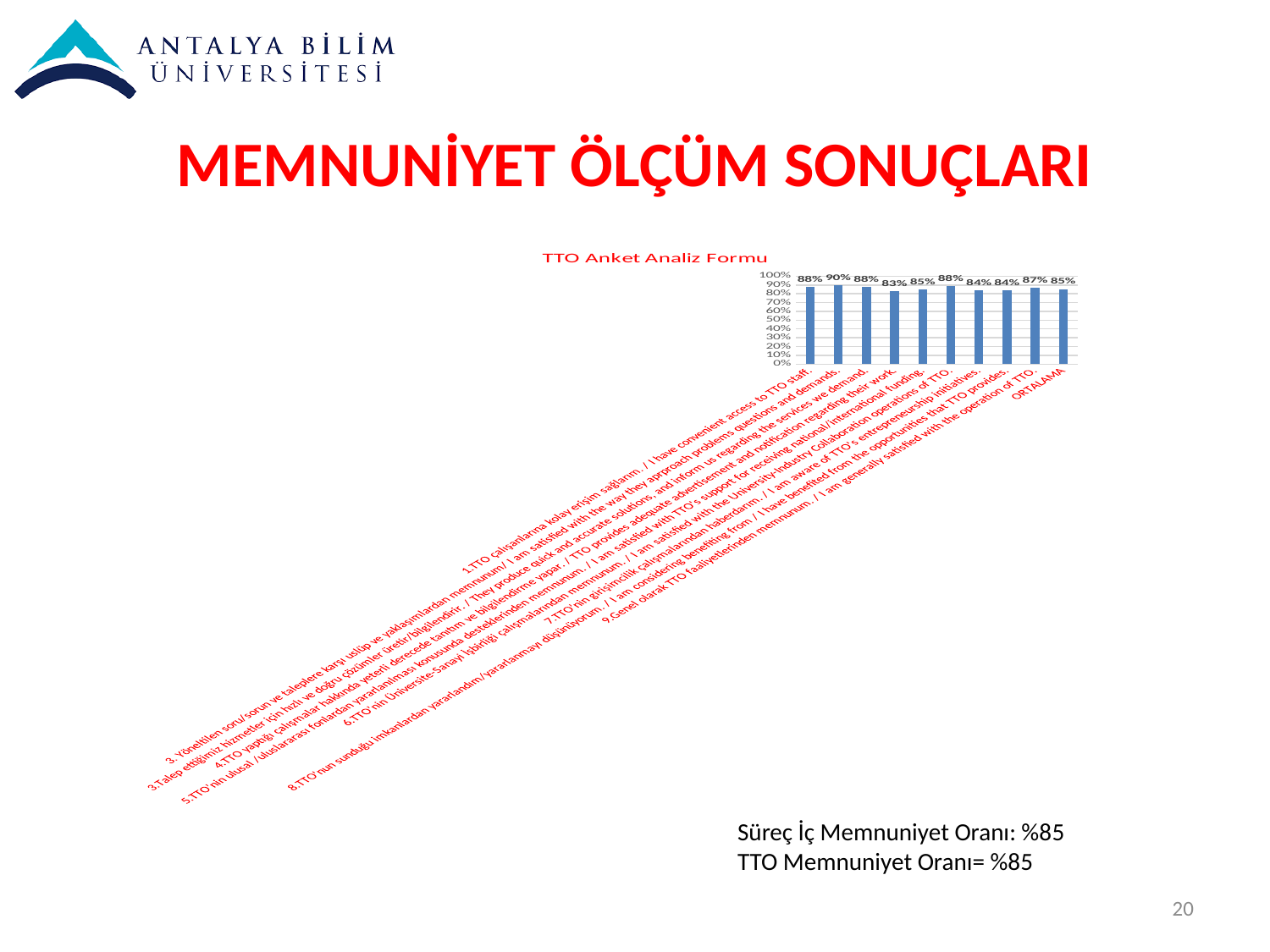
What is the lowest value shown in the chart? 83% What is the maximum value shown on the vertical axis? 100% What is the value of the first bar (1.TTO çalışanlarına kolay erişim sağlarım)? 88% What is the difference between the highest bar (90%) and the lowest bar (83%)? 7% What is the value of the ORTALAMA bar? 85% Which is larger, the second bar or the fourth bar? the second bar (90%) Is the value of the ORTALAMA bar greater or less than 50%? greater What kind of chart is shown on the slide? bar chart How many bars does the chart contain? 10 What is the highest value shown in the chart? 90% What is the value of the last bar before ORTALAMA (9.Genel olarak TTO faaliyetlerinden memnunum)? 87% What is the title of the chart? TTO Anket Analiz Formu